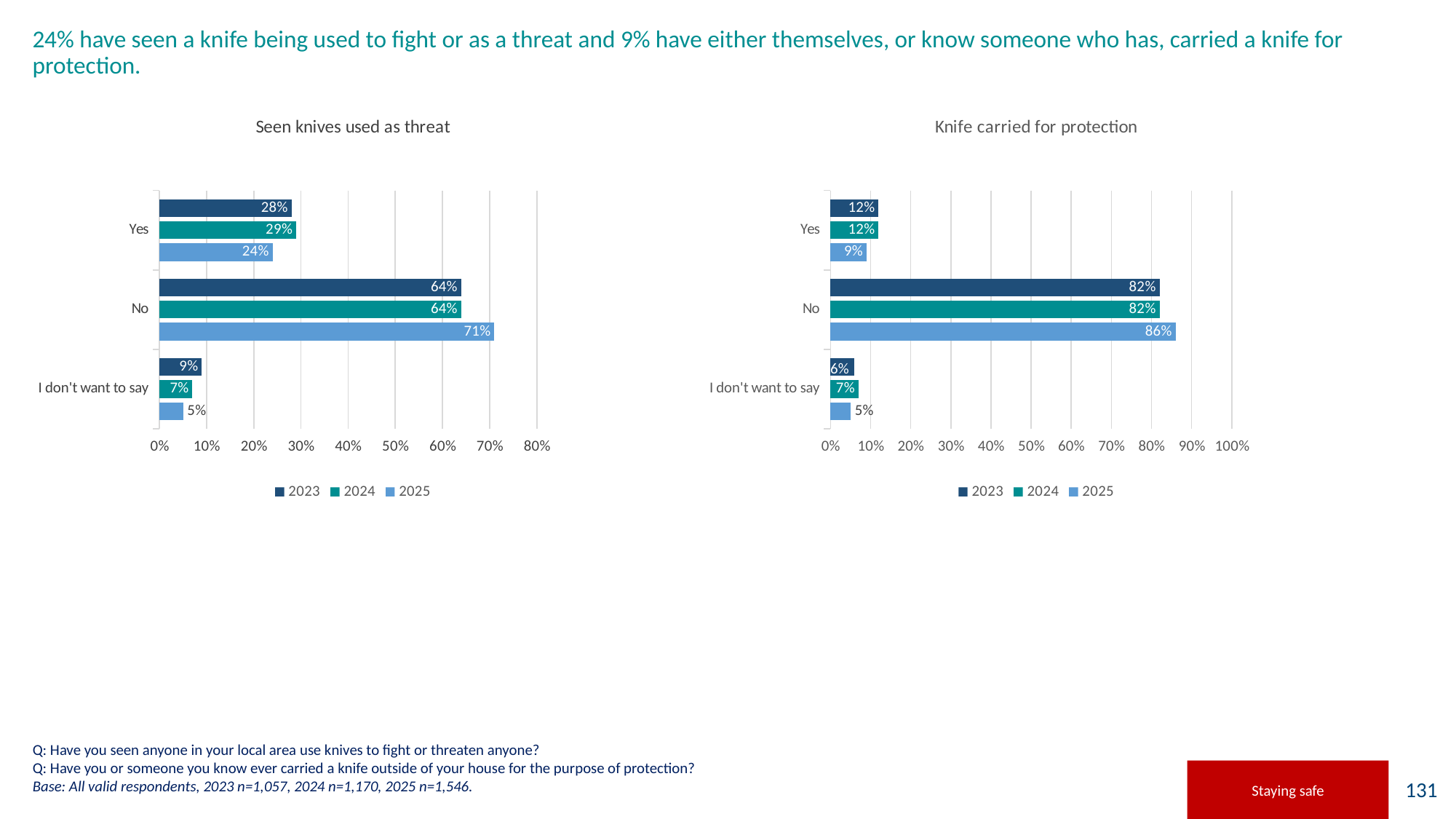
In the 'Seen knives used as threat' chart, which category has the highest value in 2025? No How many series does the legend list in the 'Knife carried for protection' chart? 3 How many categories are shown in the 'Seen knives used as threat' chart? 3 In the 'Knife carried for protection' chart, what is the difference between the 2023 and 2025 values for 'Yes'? 3% In the 'Seen knives used as threat' chart, which is larger: the 2024 value for 'Yes' or the 2025 value for 'Yes'? 2024 In the 'Knife carried for protection' chart, what is the value for 'Yes' in 2024? 12% What kind of chart is the 'Knife carried for protection' chart? Bar chart In the 'Knife carried for protection' chart, which category has the lowest value in 2025? I don't want to say In the 'Seen knives used as threat' chart, what is the value for 'I don't want to say' in 2023? 9% In the 'Seen knives used as threat' chart, what is the difference between the 2025 and 2023 values for 'No'? 7% In the 'Knife carried for protection' chart, what is the value for 'No' in 2025? 86% In the 'Seen knives used as threat' chart, what is the value for 'Yes' in 2025? 24%